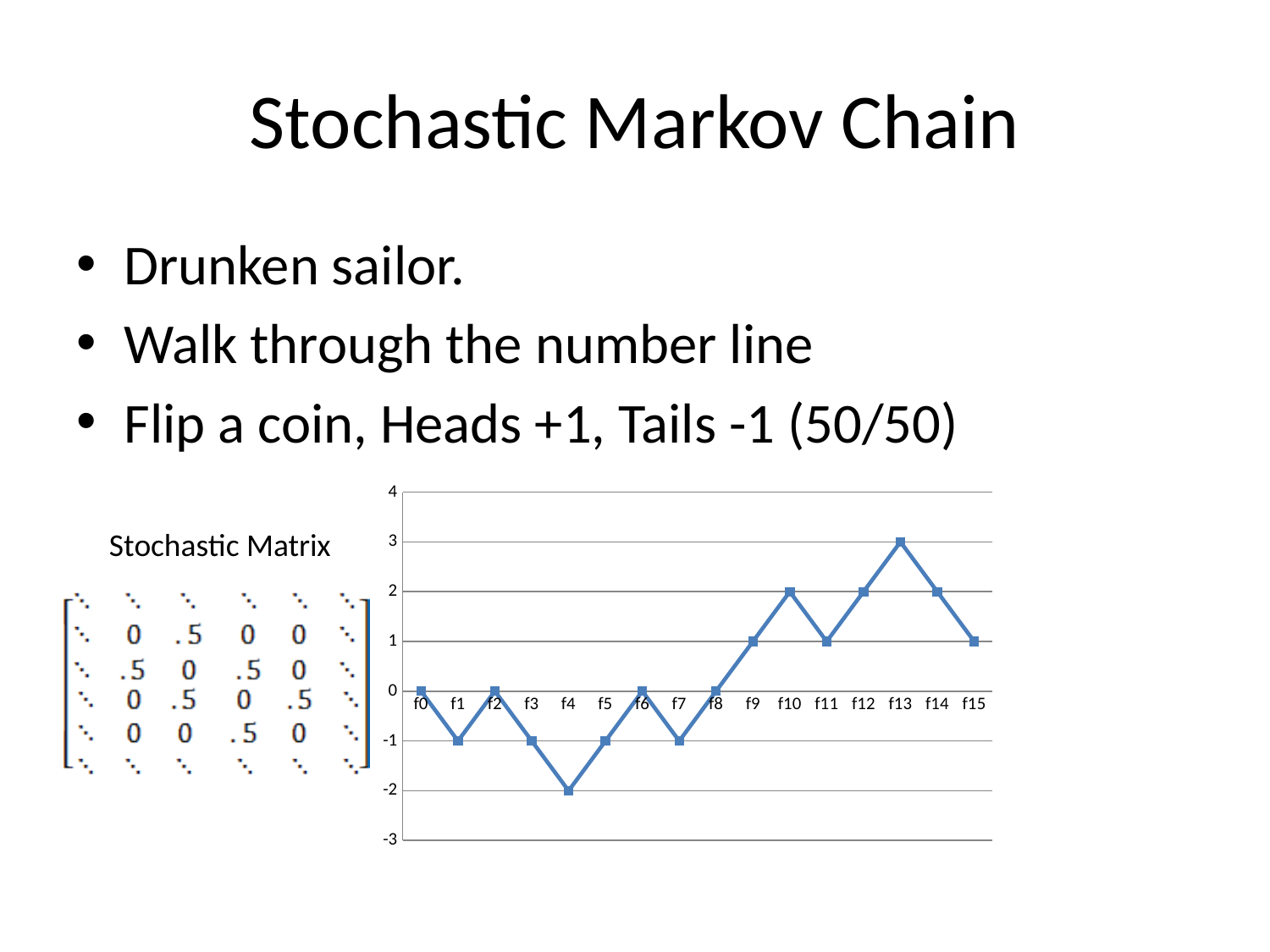
At which point does the line chart reach its highest value? f13 What is the difference between the values at f13 and f4 in the line chart? 5 What is the value at f15 in the line chart? 1 What kind of chart is shown on the slide? line chart Which is larger in the line chart, the value at f12 or the value at f11? f12 What is the value at f13 in the line chart? 3 What is the value at f10 in the line chart? 2 What is the label of the first point on the x axis of the line chart? f0 Is the value at f9 in the line chart greater or less than 0? greater How many points are plotted along the x axis of the line chart? 16 What is the value at f4 in the line chart? -2 At which point does the line chart reach its lowest value? f4